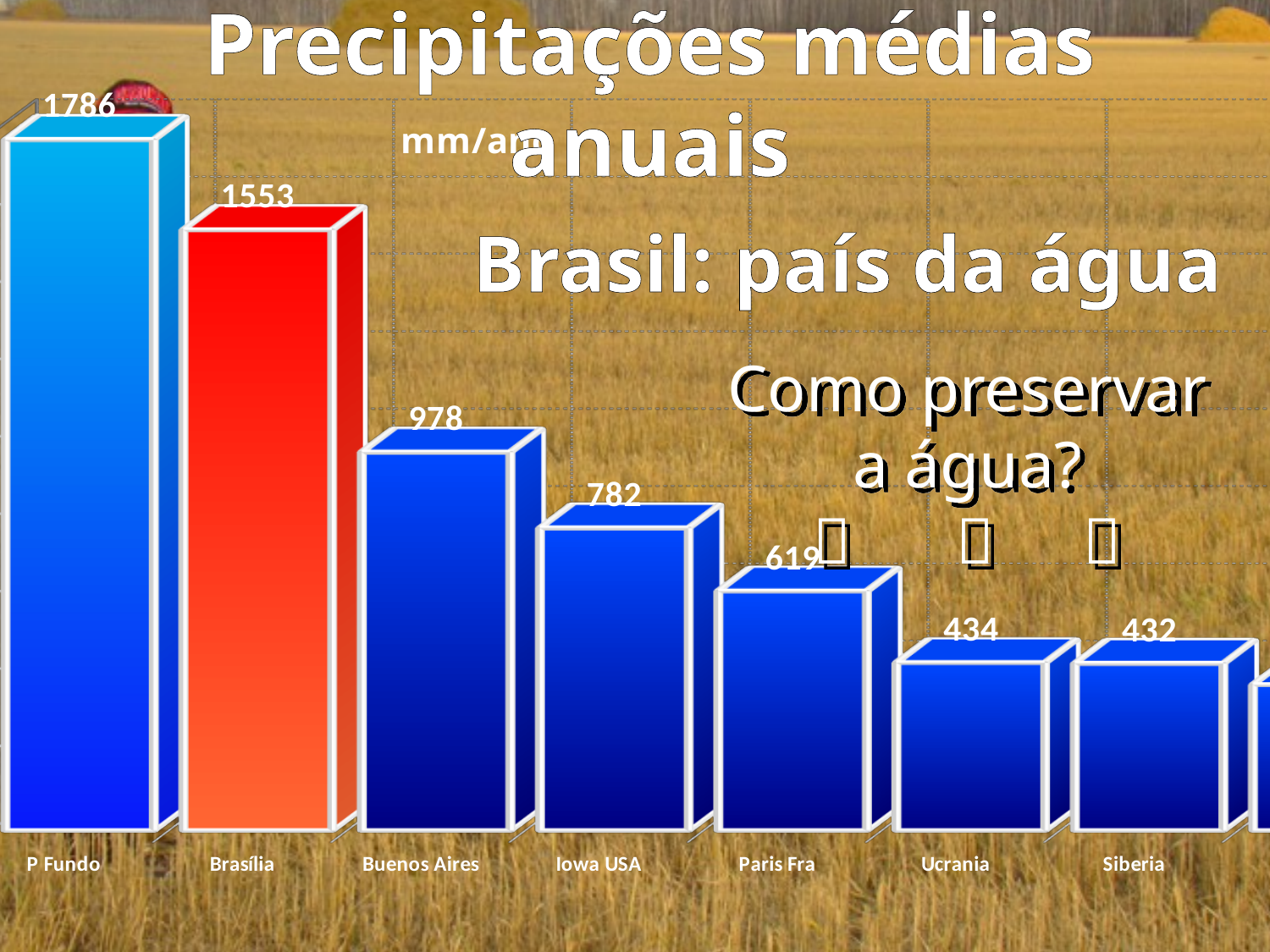
What value is shown for Iowa USA? 782 Which labeled location has the lowest precipitation value? Siberia What type of chart is shown on the slide? bar chart What is the difference between the values for P Fundo and Brasília? 233 What value is shown for Paris Fra? 619 What is the difference between the values for Ucrania and Siberia? 2 What value is shown for Buenos Aires? 978 Which labeled location has the highest precipitation value? P Fundo What is the average annual precipitation shown for P Fundo? 1786 What value is shown for Brasília? 1553 Which bar is coloured red rather than blue? Brasília Which has a higher value, Buenos Aires or Iowa USA? Buenos Aires